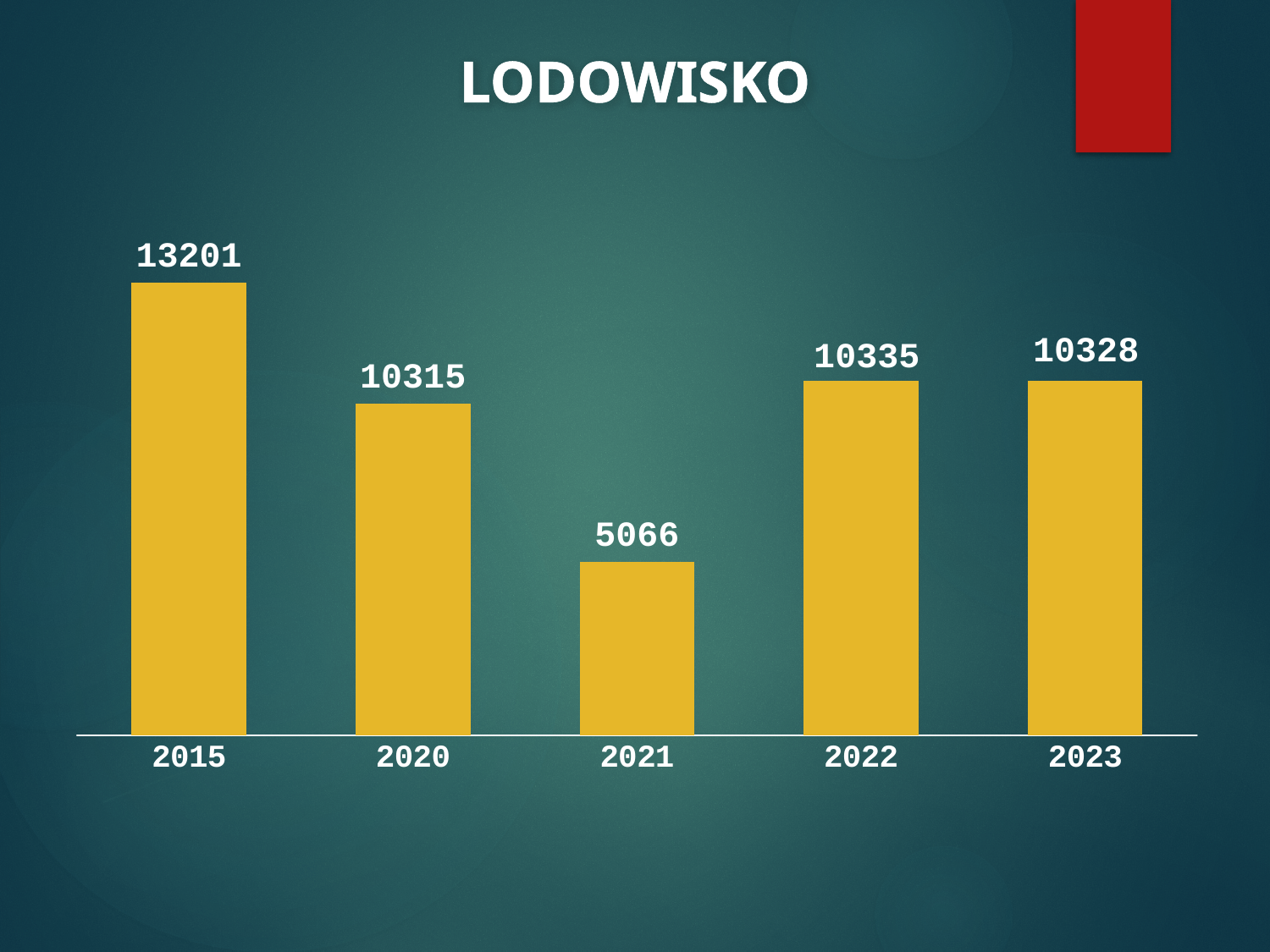
What is the difference between the values for 2015 and 2021? 8135 What is the value for 2021? 5066 What is the title of the chart? LODOWISKO Which year has the lowest value? 2021 What is the value for 2020? 10315 What is the difference between the values for 2022 and 2023? 7 Which year has the highest value? 2015 What kind of chart is shown on the slide? bar chart How many years are shown on the chart? 5 Which is larger, the value for 2020 or the value for 2021? 2020 What is the value for 2015? 13201 What is the value for 2023? 10328